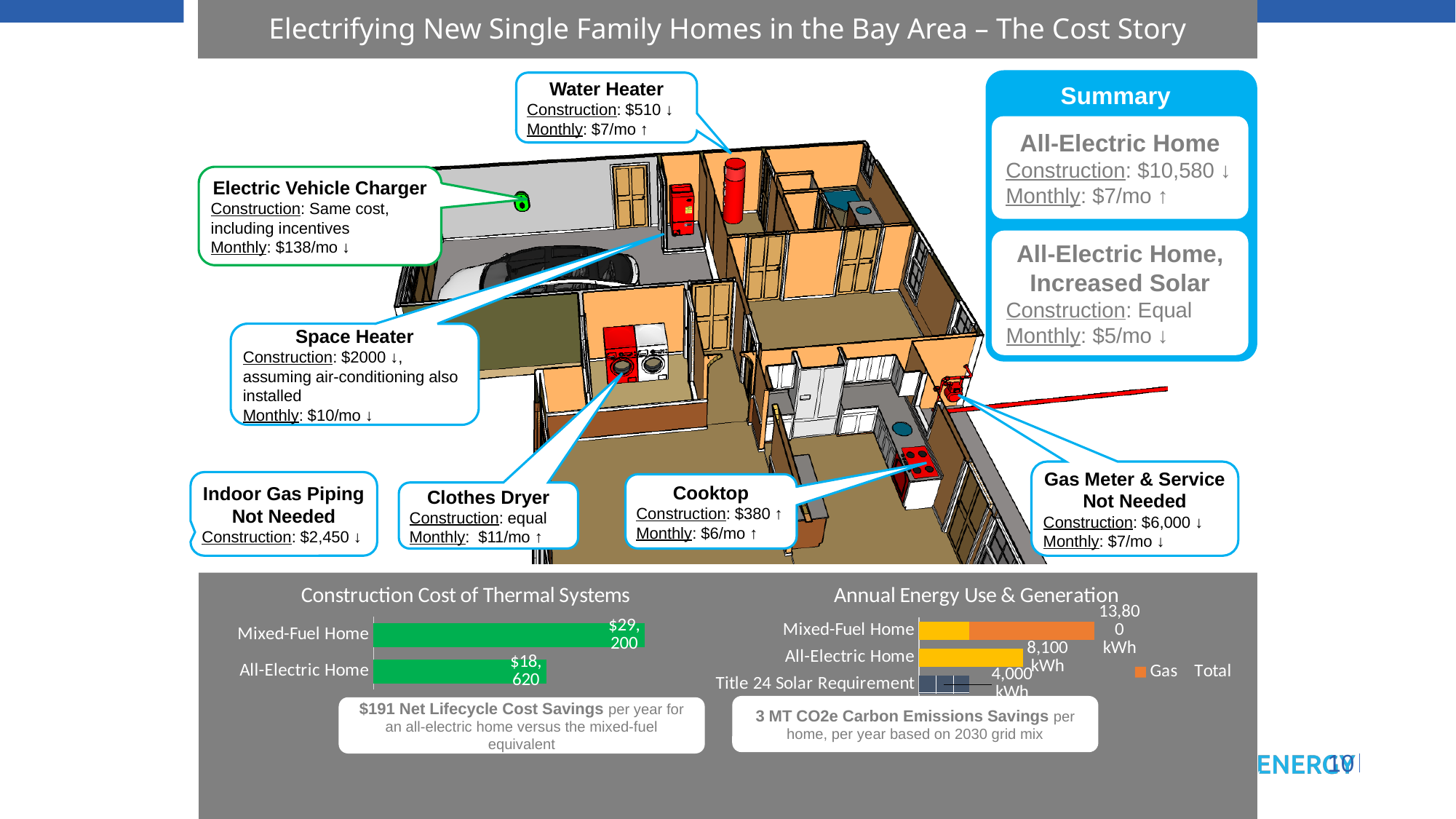
In the Annual Energy Use & Generation chart, which is larger: Mixed-Fuel Home or All-Electric Home? Mixed-Fuel Home What kind of chart is the Construction Cost of Thermal Systems chart? Bar chart In the Construction Cost of Thermal Systems chart, what is the value for All-Electric Home? $18,620 In the Construction Cost of Thermal Systems chart, which category has the highest value? Mixed-Fuel Home In the Annual Energy Use & Generation chart, how many categories are shown? 3 In the Construction Cost of Thermal Systems chart, what is the difference between the Mixed-Fuel Home and All-Electric Home values? $10,580 In the Construction Cost of Thermal Systems chart, what is the value for Mixed-Fuel Home? $29,200 In the Annual Energy Use & Generation chart, which category has the lowest value? Title 24 Solar Requirement In the Construction Cost of Thermal Systems chart, how many categories are shown? 2 In the Annual Energy Use & Generation chart, what is the value labelled for All-Electric Home? 8,100 kWh In the Annual Energy Use & Generation chart, what is the value labelled for Mixed-Fuel Home? 13,800 kWh In the Annual Energy Use & Generation chart, what is the value labelled for Title 24 Solar Requirement? 4,000 kWh